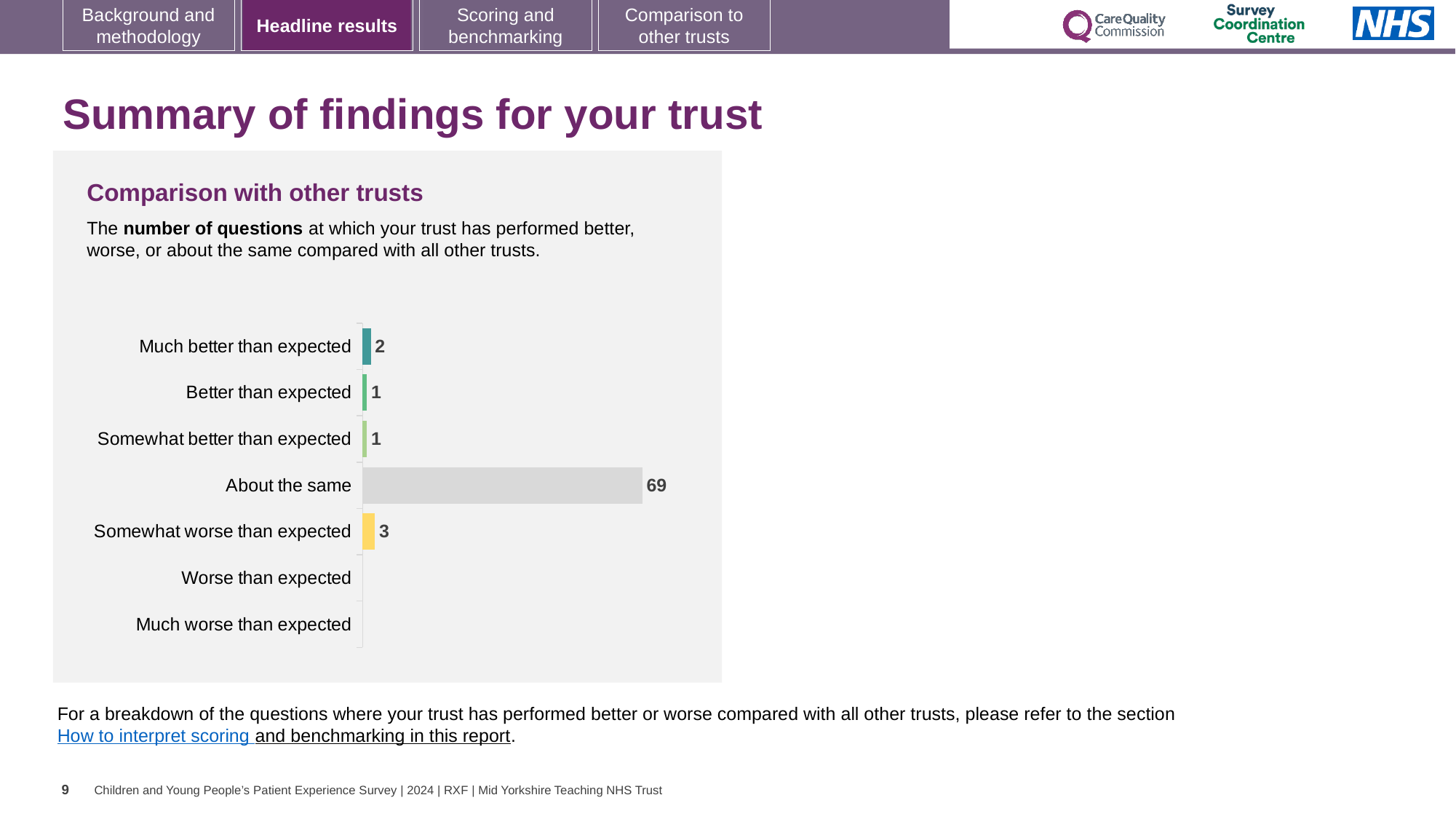
What kind of chart is shown on the slide? Bar chart How many categories are shown on the chart? 7 What colour is the bar for 'Somewhat worse than expected'? Yellow What is the difference between the values for 'About the same' and 'Somewhat worse than expected'? 66 What is the value for 'Better than expected'? 1 What is the value for 'Much better than expected'? 2 Which category has the highest number of questions? About the same What is the value for 'Somewhat worse than expected'? 3 What is the total number of questions across the 'Much better than expected', 'Better than expected' and 'Somewhat better than expected' categories? 4 What is the title of the chart? Comparison with other trusts How many questions were rated 'About the same'? 69 Which is larger: the value for 'Much better than expected' or 'Somewhat worse than expected'? Somewhat worse than expected